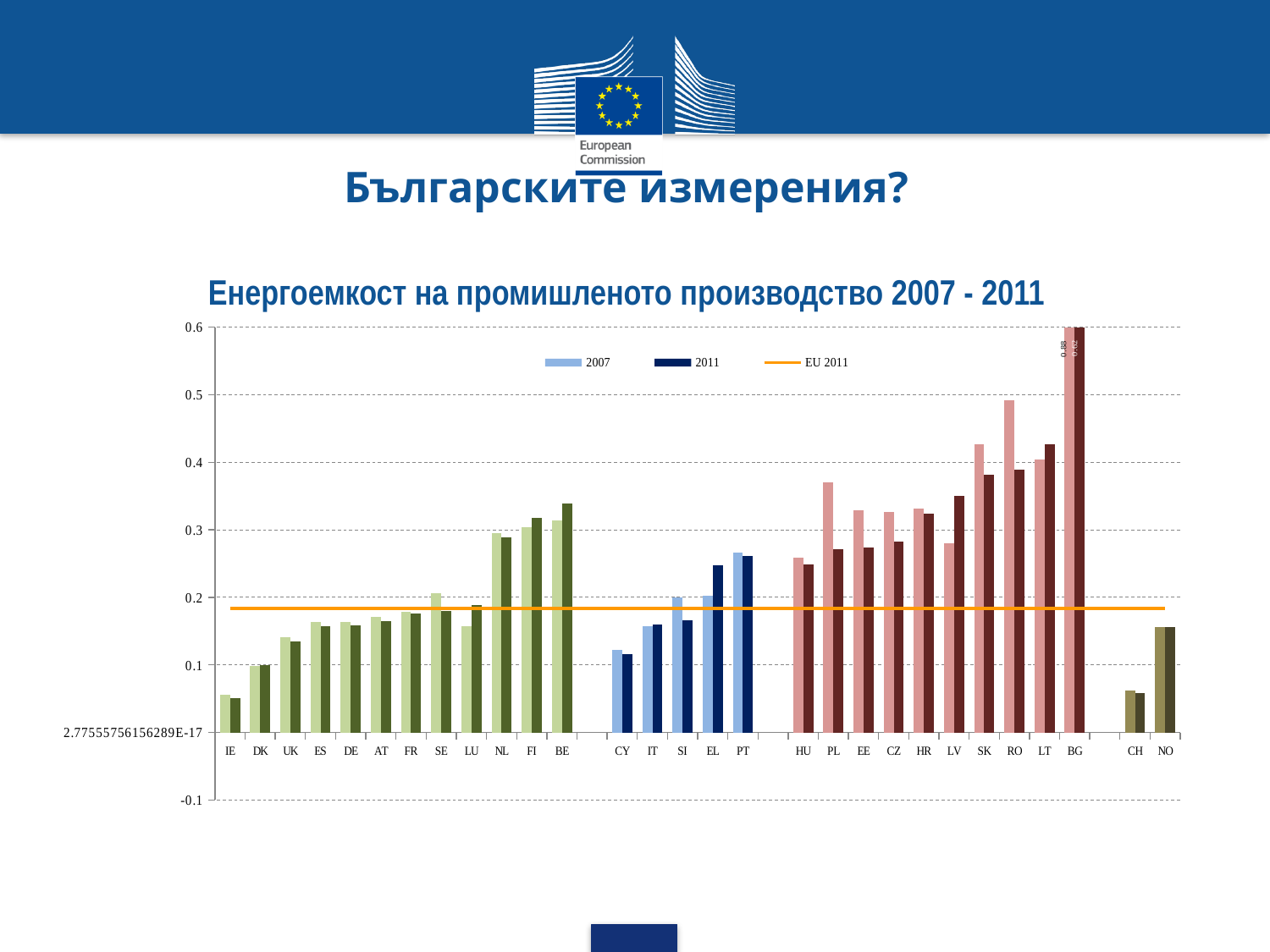
Which country has the highest values in the chart? BG Which has the larger 2007 value, RO or LT? RO Which has the larger 2011 value, BE or CY? BE Is the 2007 value for RO greater or less than 0.4? greater How many entries does the legend of the chart list? 3 Is the 2007 value for PL greater or less than 0.3? greater How many countries are shown on the x axis of the chart? 29 What kind of chart is shown on the slide? bar chart What is the title of the chart? Енергоемкост на промишленото производство 2007 - 2011 Is the 2011 value for IE greater or less than 0.1? less Which country has the lowest values in the chart? IE